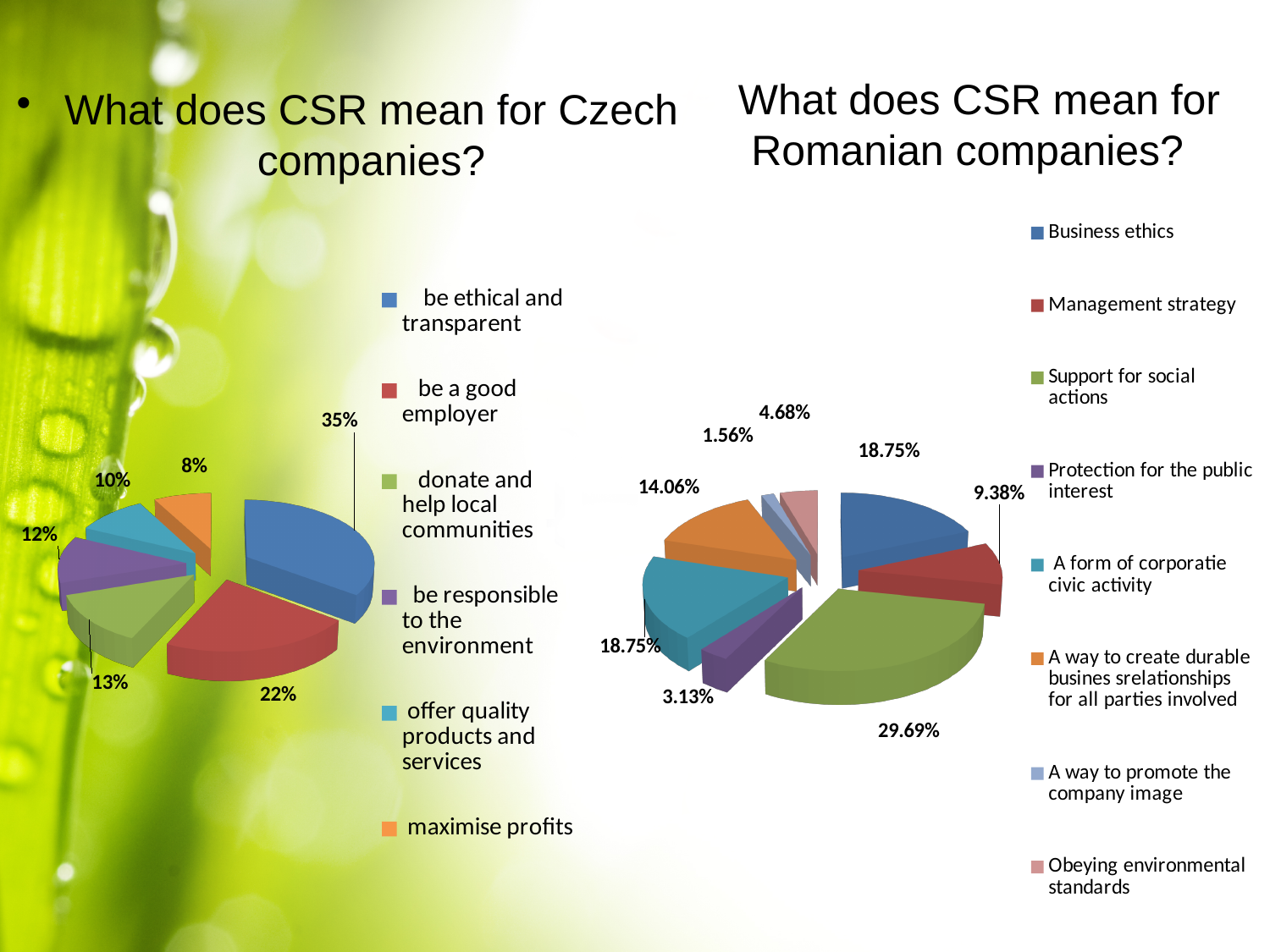
How many categories does the legend of the chart 'What does CSR mean for Czech companies?' list? 6 In the chart 'What does CSR mean for Romanian companies?', which category has the smallest share? A way to promote the company image What type of chart is used for 'What does CSR mean for Romanian companies?'? pie chart In the chart 'What does CSR mean for Czech companies?', what is the difference between 'be a good employer' and 'donate and help local communities'? 9% In the chart 'What does CSR mean for Romanian companies?', what percentage is shown for 'Support for social actions'? 29.69% In the chart 'What does CSR mean for Romanian companies?', what percentage is shown for 'Management strategy'? 9.38% How many categories does the legend of the chart 'What does CSR mean for Romanian companies?' list? 8 In the chart 'What does CSR mean for Czech companies?', which category has the largest share? be ethical and transparent In the chart 'What does CSR mean for Czech companies?', what percentage is shown for 'be ethical and transparent'? 35% In the chart 'What does CSR mean for Czech companies?', which category has the smallest share? maximise profits In the chart 'What does CSR mean for Romanian companies?', which is larger: 'Business ethics' or 'A way to create durable business relationships for all parties involved'? Business ethics In the chart 'What does CSR mean for Czech companies?', what percentage is shown for 'maximise profits'? 8%